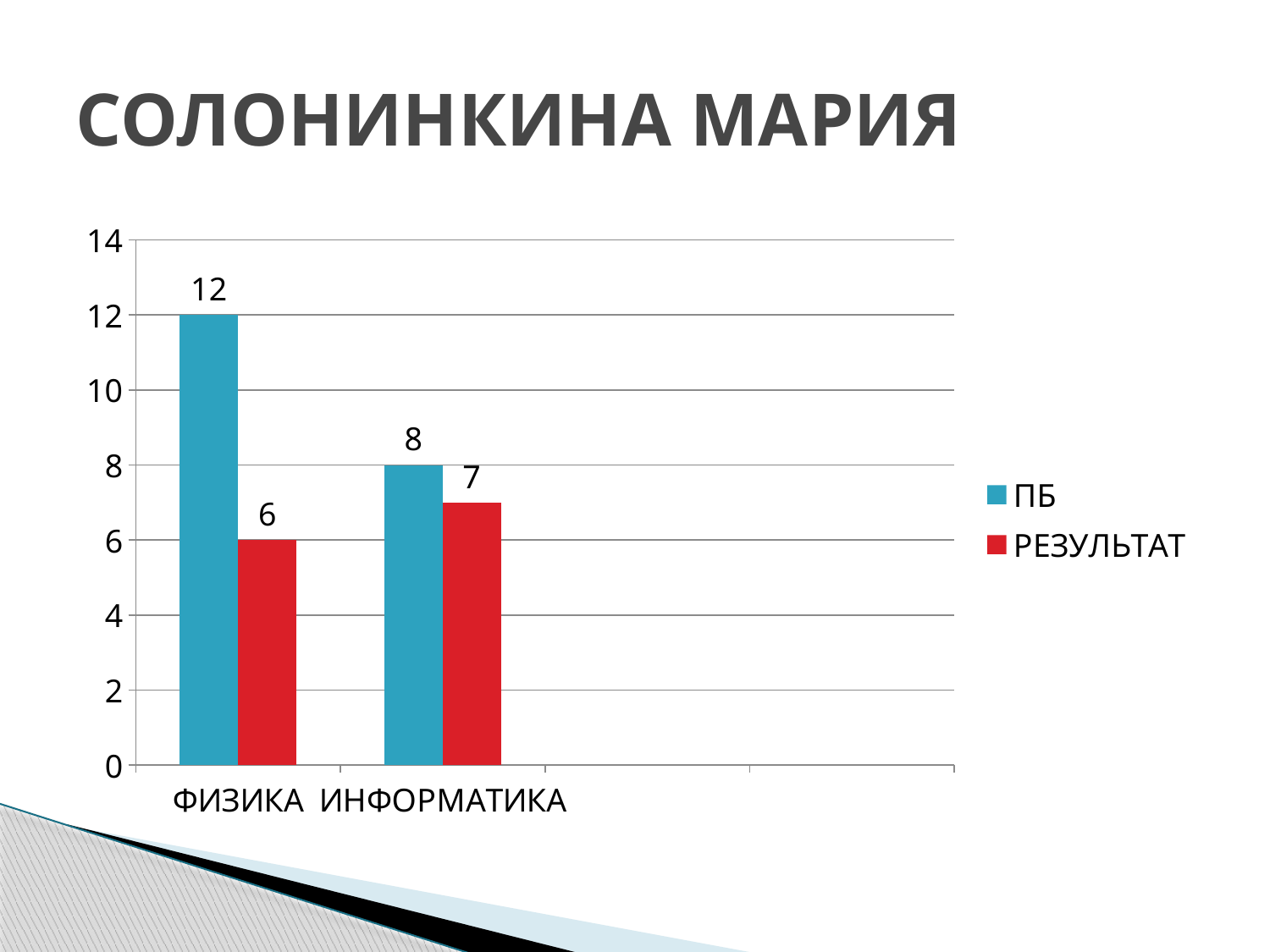
What is the title of the slide? СОЛОНИНКИНА МАРИЯ How many series does the legend list? 2 Which category has the lowest РЕЗУЛЬТАТ value? ФИЗИКА What is the ПБ value for ФИЗИКА? 12 Which category has the highest ПБ value? ФИЗИКА What kind of chart is shown on the slide? bar chart Which is larger for ИНФОРМАТИКА, ПБ or РЕЗУЛЬТАТ? ПБ What is the РЕЗУЛЬТАТ value for ИНФОРМАТИКА? 7 What is the difference between the ПБ and РЕЗУЛЬТАТ values for ФИЗИКА? 6 How many categories are shown on the x axis? 2 What is the РЕЗУЛЬТАТ value for ФИЗИКА? 6 What is the ПБ value for ИНФОРМАТИКА? 8